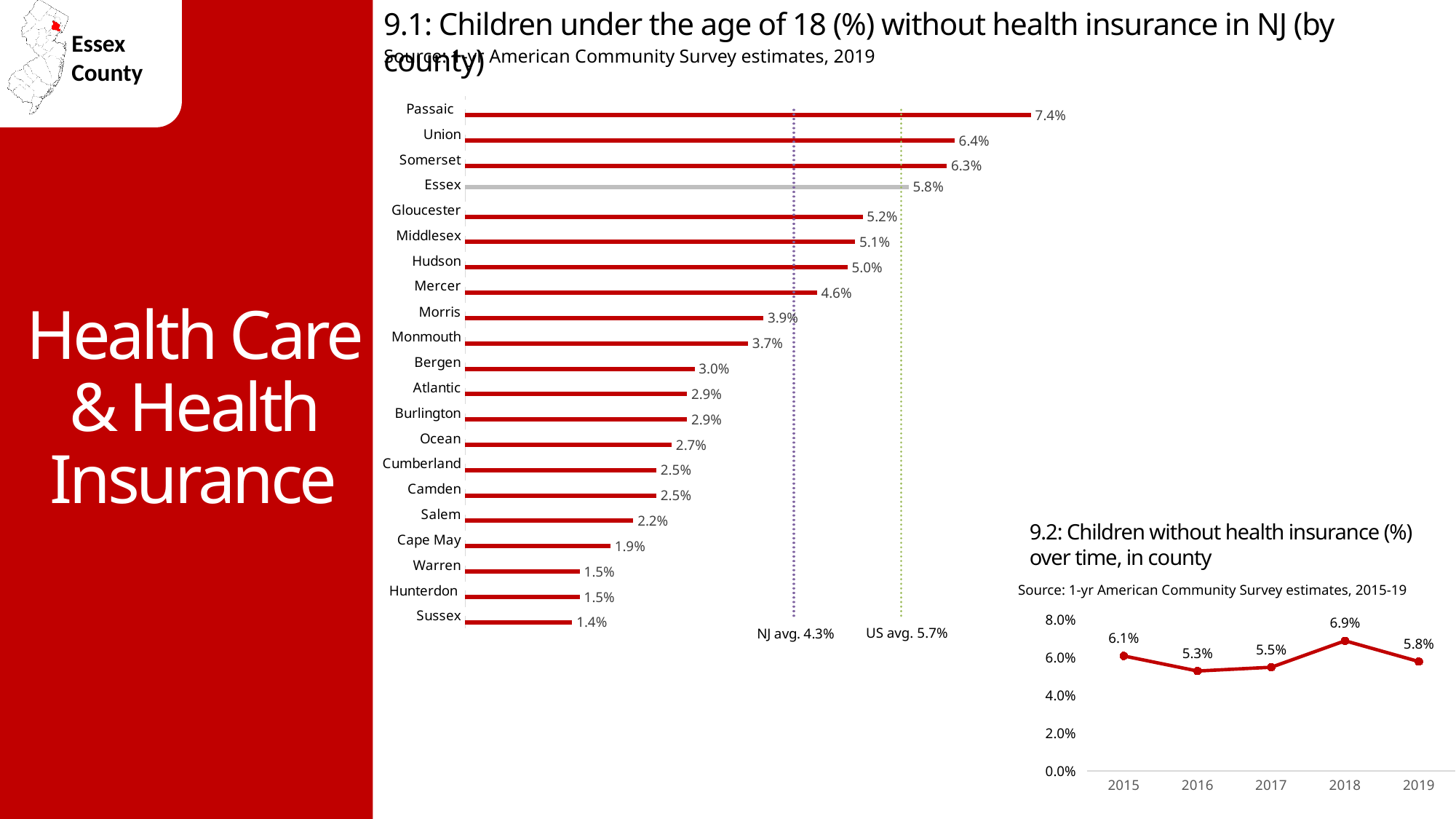
In chart 9.1, what is the value for Mercer? 4.6% In chart 9.1, which county has a higher value, Union or Hudson? Union In chart 9.1, how many counties are shown? 21 In chart 9.2 (children without health insurance over time), what is the value for 2018? 6.9% In chart 9.1, which county has the highest percentage of children without health insurance? Passaic In chart 9.1, what is the difference between the values for Passaic and Sussex? 6.0% What kind of chart is chart 9.2? Line chart In chart 9.1, which county has the lowest percentage of children without health insurance? Sussex In chart 9.2, which year has the lowest value? 2016 In chart 9.1, what is the NJ average shown by the dotted reference line? 4.3% In chart 9.2, what is the difference between the 2018 and 2019 values? 1.1% In chart 9.1 (children under 18 without health insurance by county), what is the value for Essex? 5.8%